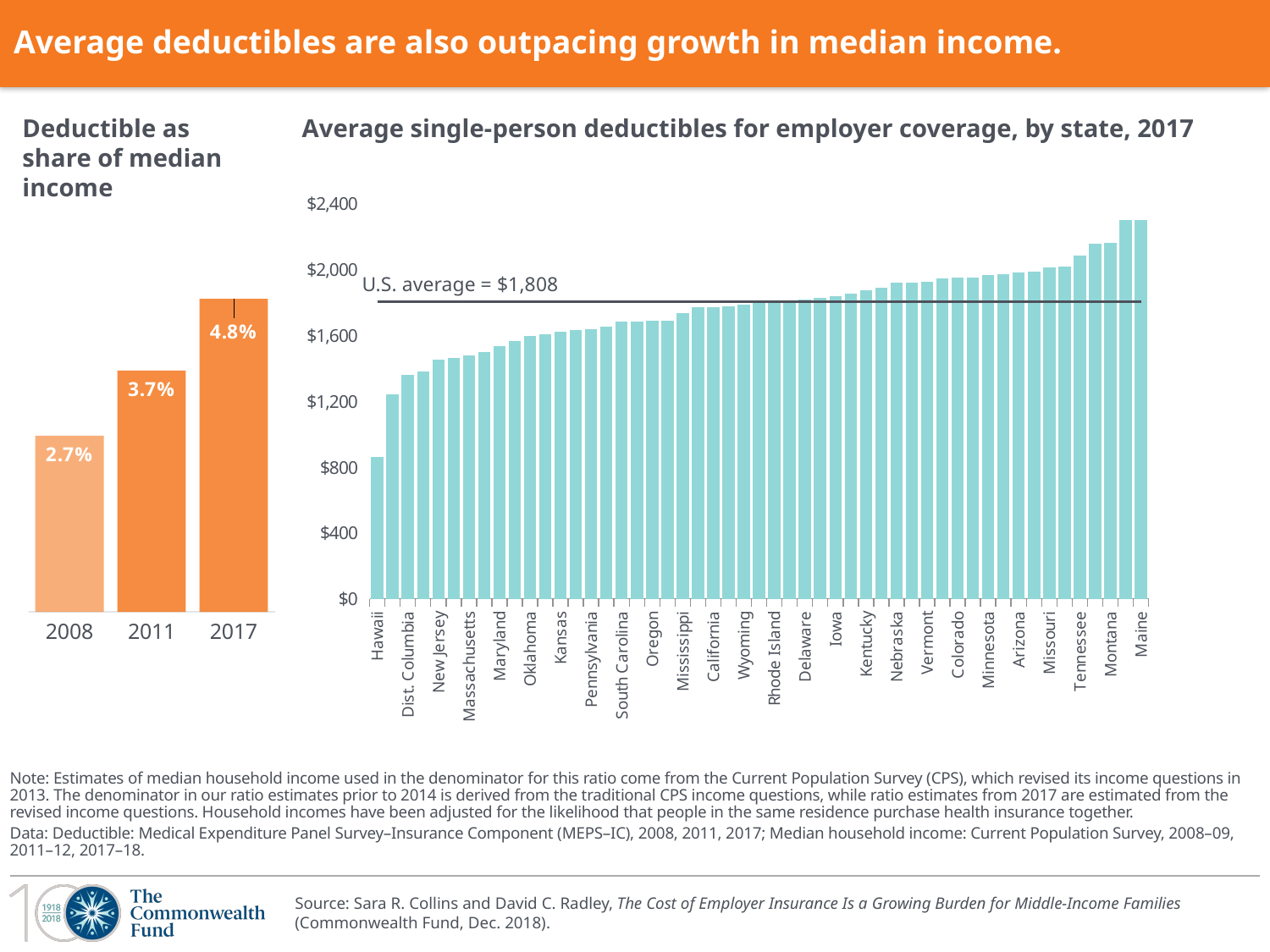
In the right chart, 'Average single-person deductibles for employer coverage, by state, 2017', which state has the lowest deductible? Hawaii In the right chart, 'Average single-person deductibles for employer coverage, by state, 2017', what is the U.S. average deductible shown? $1,808 In the right chart, 'Average single-person deductibles for employer coverage, by state, 2017', is the value for Hawaii greater or less than $1,200? less In the right chart, 'Average single-person deductibles for employer coverage, by state, 2017', is the value for Montana greater or less than $2,000? greater In the left chart, 'Deductible as share of median income', what is the value for 2011? 3.7% In the left chart, 'Deductible as share of median income', do the values rise or fall from 2008 to 2017? rise In the right chart, 'Average single-person deductibles for employer coverage, by state, 2017', which state has the highest deductible? Maine In the left chart, 'Deductible as share of median income', what is the value for 2008? 2.7% What kind of chart is the right chart, 'Average single-person deductibles for employer coverage, by state, 2017'? bar chart In the left chart, 'Deductible as share of median income', how many years are shown? 3 In the left chart, 'Deductible as share of median income', by how many percentage points did the share rise from 2008 to 2017? 2.1 percentage points In the left chart, 'Deductible as share of median income', what is the value for 2017? 4.8%